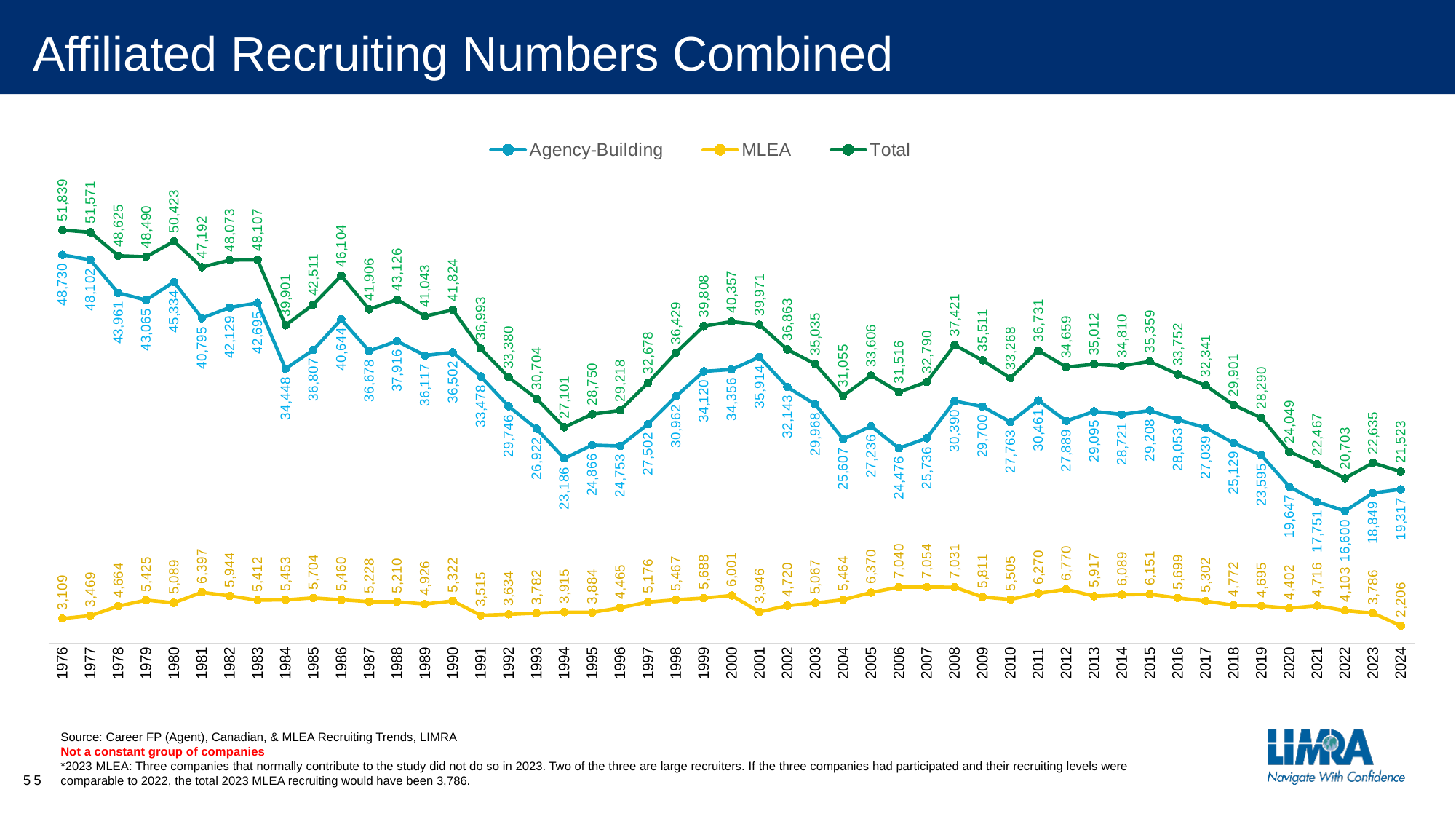
Overall, does the Total line rise or fall from 1976 to 2024? Fall In which year is the MLEA value lowest? 2024 What is the Agency-Building value for 2024? 19,317 In which year is the Agency-Building value highest? 1976 What is the title of the chart? Affiliated Recruiting Numbers Combined In which year is the Total value lowest? 2022 What is the difference between the Total value in 1976 and the Total value in 2024? 30,316 What is the MLEA value for 2007? 7,054 How many series does the legend list? 3 What type of chart is shown on the slide? Line chart What is the Total value for 1976? 51,839 Which is larger, the Agency-Building value in 2001 or the Agency-Building value in 2000? 2001